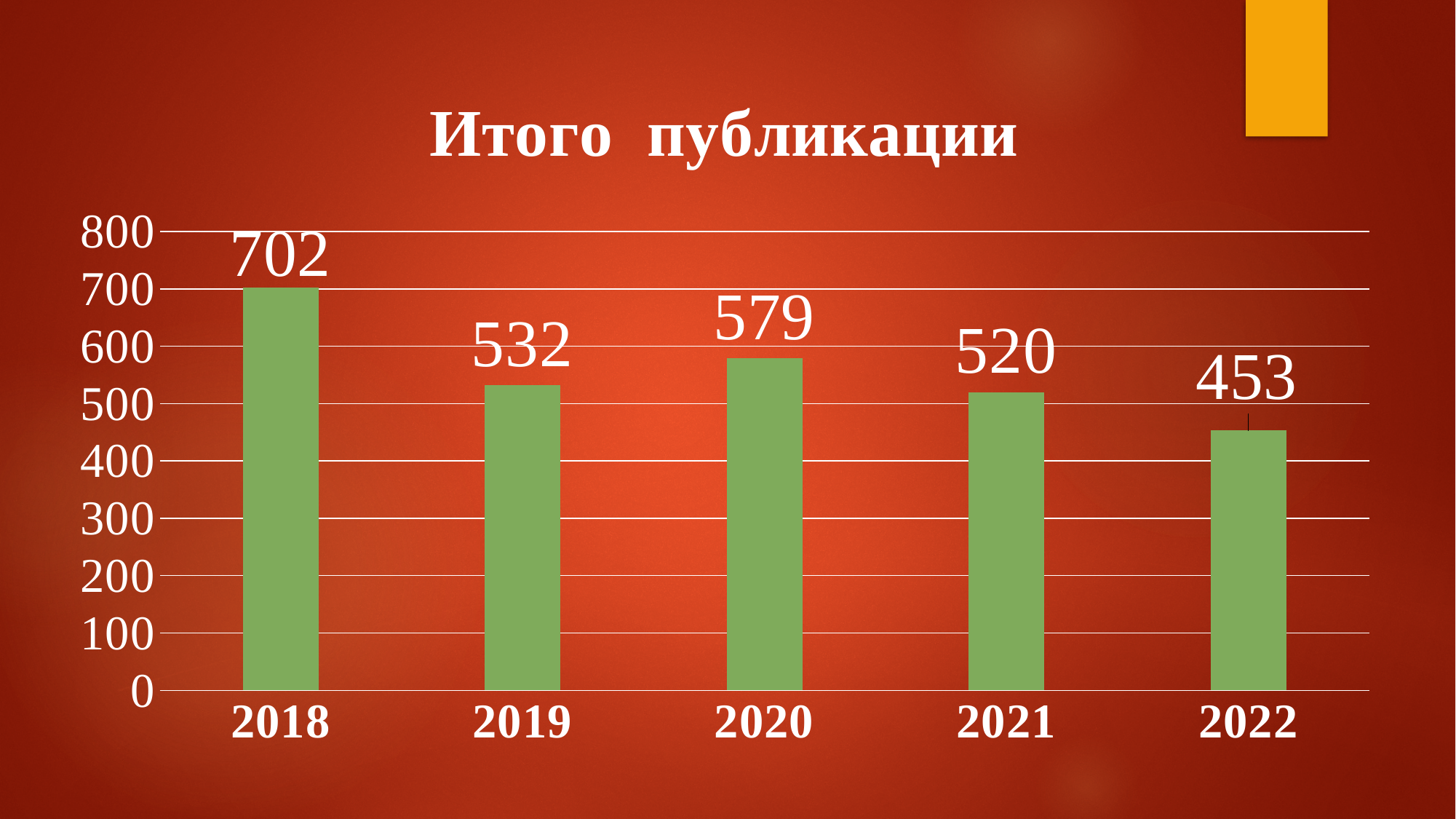
What is the difference between the values for 2021 and 2022? 67 What is the value for 2022? 453 Which year has the highest value? 2018 Which year has the lowest value? 2022 How many years are shown on the x axis? 5 What is the title of the chart? Итого публикации What is the value for 2020? 579 Which is larger, the value for 2019 or the value for 2020? 2020 What is the difference between the values for 2018 and 2019? 170 Is the value for 2021 greater or less than 600? less What is the value for 2018? 702 What kind of chart is shown on the slide? bar chart